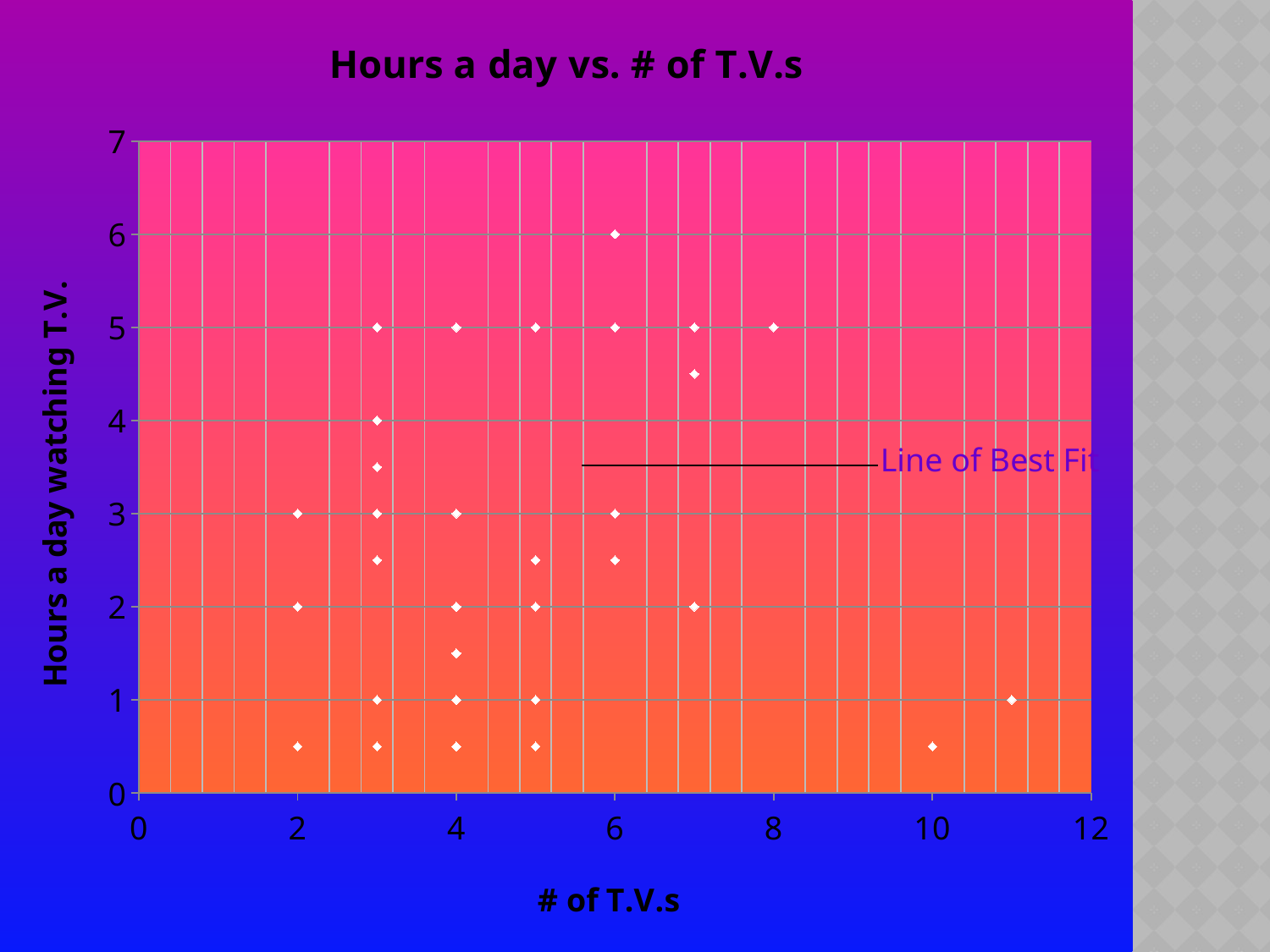
How many T.V.s does the point with the highest hours a day (6 hours) have? 6 What is the label on the vertical axis of the chart? Hours a day watching T.V. How many hours a day does the point with 8 T.V.s show? 5 How many points are plotted at 6 T.V.s? 4 What kind of chart is shown on the slide? scatter chart What is the largest number of T.V.s for any plotted point? 11 What is the highest value shown on the vertical axis? 7 What is the title of the chart? Hours a day vs. # of T.V.s Is the value for the point at 10 T.V.s greater or less than 1 hour a day? less How many hours a day does the point with 11 T.V.s show? 1 What is the highest number of hours a day plotted on the chart? 6